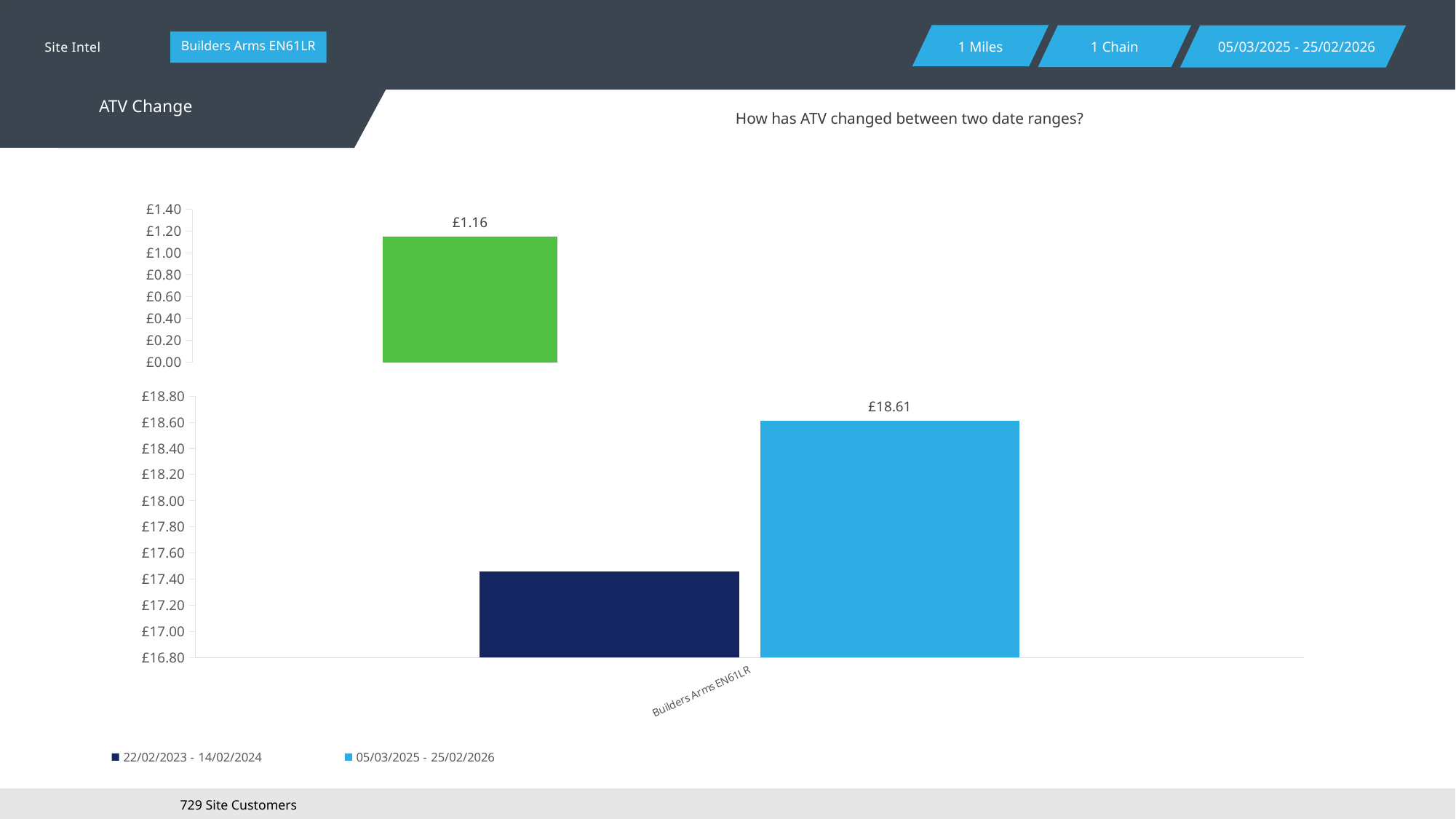
In the top chart, what value is printed on the green bar? £1.16 In the bottom chart, which series has the larger value: 22/02/2023 - 14/02/2024 or 05/03/2025 - 25/02/2026? 05/03/2025 - 25/02/2026 What is the title of the chart section on this slide? ATV Change How many categories are shown on the x axis of the bottom chart? 1 In the top chart, is the value of the green bar greater or less than £1.00? greater What is the category label on the x axis of the bottom chart? Builders Arms EN61LR In the bottom chart, is the value for the 22/02/2023 - 14/02/2024 series greater or less than £17.00? greater What kind of chart is the bottom chart? bar chart In the bottom chart, is the value for the 05/03/2025 - 25/02/2026 series greater or less than £18.40? greater In the bottom chart, what is the value for the 05/03/2025 - 25/02/2026 series for Builders Arms EN61LR? £18.61 How many series does the legend of the bottom chart list? 2